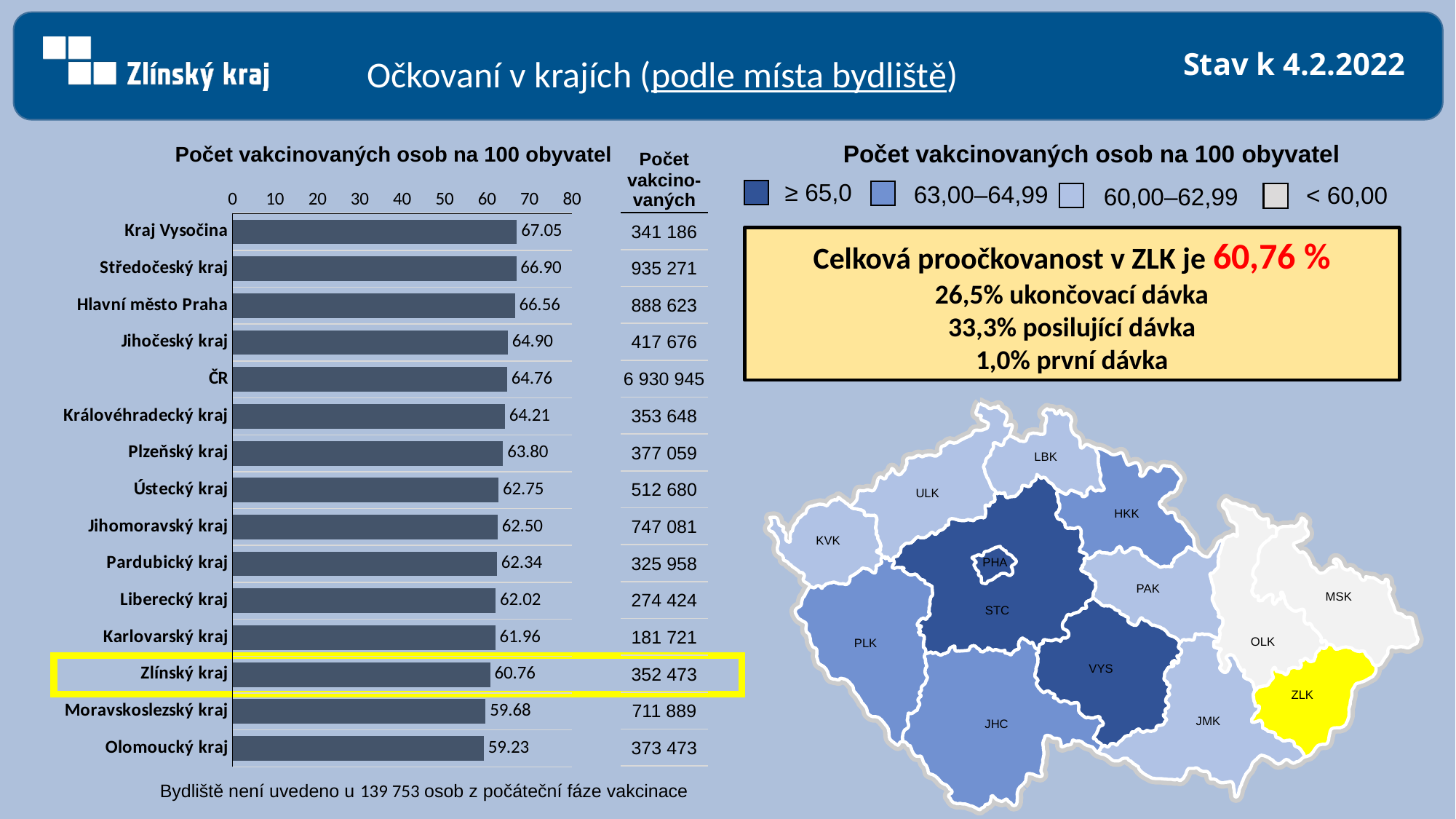
How many bars are shown in the bar chart? 15 What is the difference between the values for Kraj Vysočina and Olomoucký kraj in the bar chart? 7.82 In the bar chart, what is the value for Hlavní město Praha? 66.56 In the bar chart, which is larger: the value for Plzeňský kraj or the value for Ústecký kraj? Plzeňský kraj Which category has the lowest value in the bar chart? Olomoucký kraj Which category has the highest value in the bar chart? Kraj Vysočina What is the title of the bar chart on the left of the slide? Počet vakcinovaných osob na 100 obyvatel In the bar chart, what is the value for Zlínský kraj? 60.76 In the bar chart, what is the value for ČR? 64.76 What is the difference between the values for ČR and Zlínský kraj in the bar chart? 4.00 Is the value for Moravskoslezský kraj in the bar chart greater or less than 60? less What kind of chart is shown on the left of the slide? bar chart